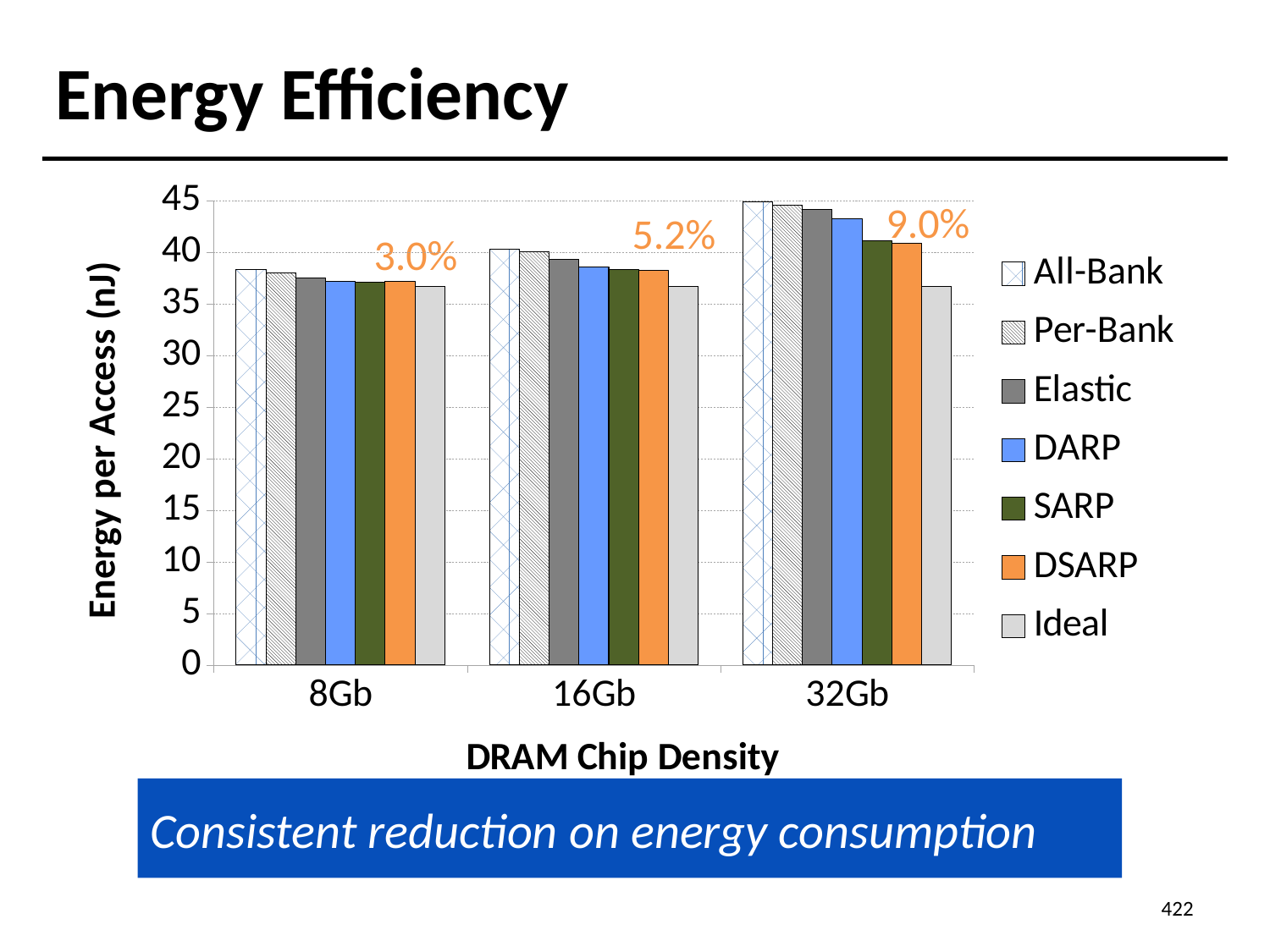
What percentage is annotated above the 8Gb group of bars? 3.0% Which series has the highest energy per access at 32Gb? All-Bank How many series does the legend list? 7 Is the value for Ideal at 32Gb greater or less than 40? less Does the energy per access for All-Bank rise or fall as DRAM chip density increases from 8Gb to 32Gb? rise What is the y-axis label of the chart? Energy per Access (nJ) What kind of chart is shown on the slide? bar chart What percentage is annotated above the 32Gb group of bars? 9.0% What percentage is annotated above the 16Gb group of bars? 5.2% Which series has the lowest energy per access at 32Gb? Ideal How many DRAM chip density categories are shown on the x axis? 3